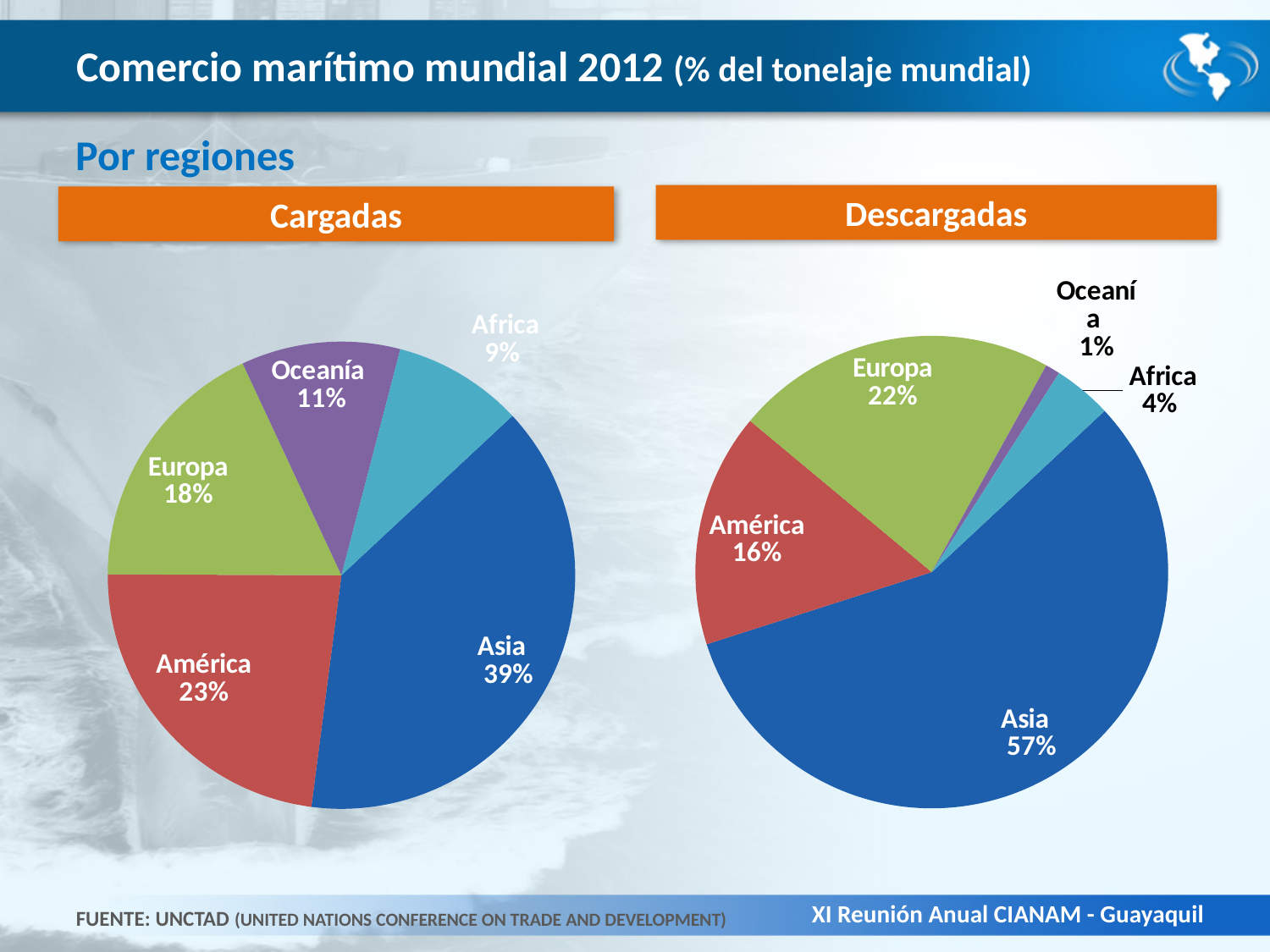
What is the difference between Asia's share in the Descargadas chart and Asia's share in the Cargadas chart? 18 percentage points In the Descargadas pie chart, which is larger: the share for Europa or the share for América? Europa In the Cargadas pie chart, which region has the smallest share? Africa In the Cargadas pie chart, which is larger: the share for América or the share for Europa? América In the Cargadas pie chart, what is the combined share of Europa and Oceanía? 29% In the Descargadas pie chart, what share does Europa have? 22% What type of chart is used for the Descargadas data? Pie chart How many regions are shown in the Cargadas pie chart? 5 In the Cargadas pie chart, which region has the largest share? Asia What is the title of the slide? Comercio marítimo mundial 2012 (% del tonelaje mundial) In the Descargadas pie chart, which region has the smallest share? Oceanía In the Cargadas pie chart, what share does Asia have? 39%